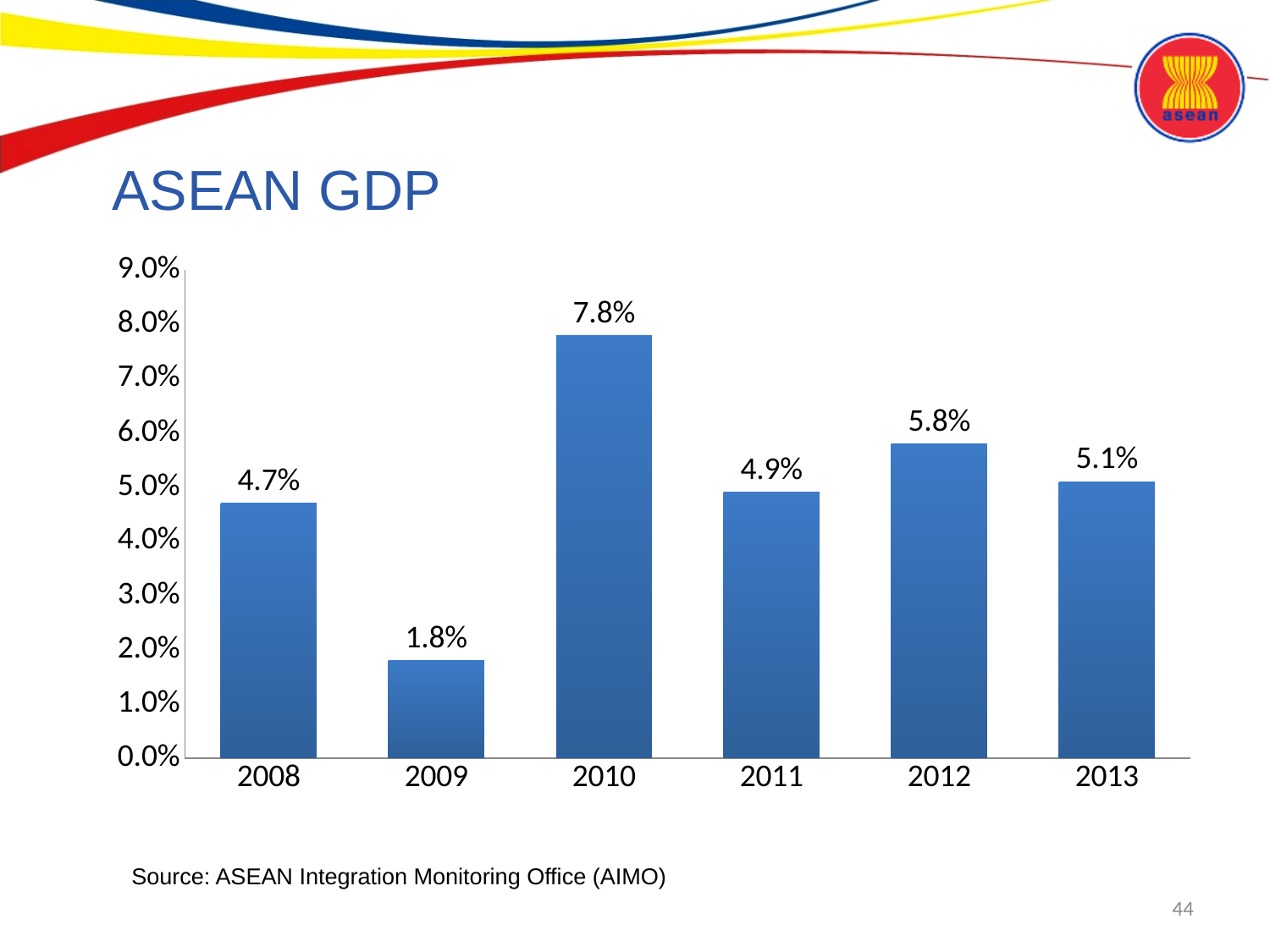
What is the difference between the values for 2012 and 2011? 0.9% What is the title of the chart? ASEAN GDP What is the ASEAN GDP growth value for 2010? 7.8% How many years are shown on the x axis? 6 What is the difference between the values for 2010 and 2009? 6.0% What is the value shown for 2009? 1.8% Is the value for 2011 greater or less than 4.0%? greater What is the value shown for 2013? 5.1% Which is larger, the value for 2008 or the value for 2012? 2012 Which year has the lowest value? 2009 Which year has the highest value? 2010 What kind of chart is shown on the slide? Bar chart